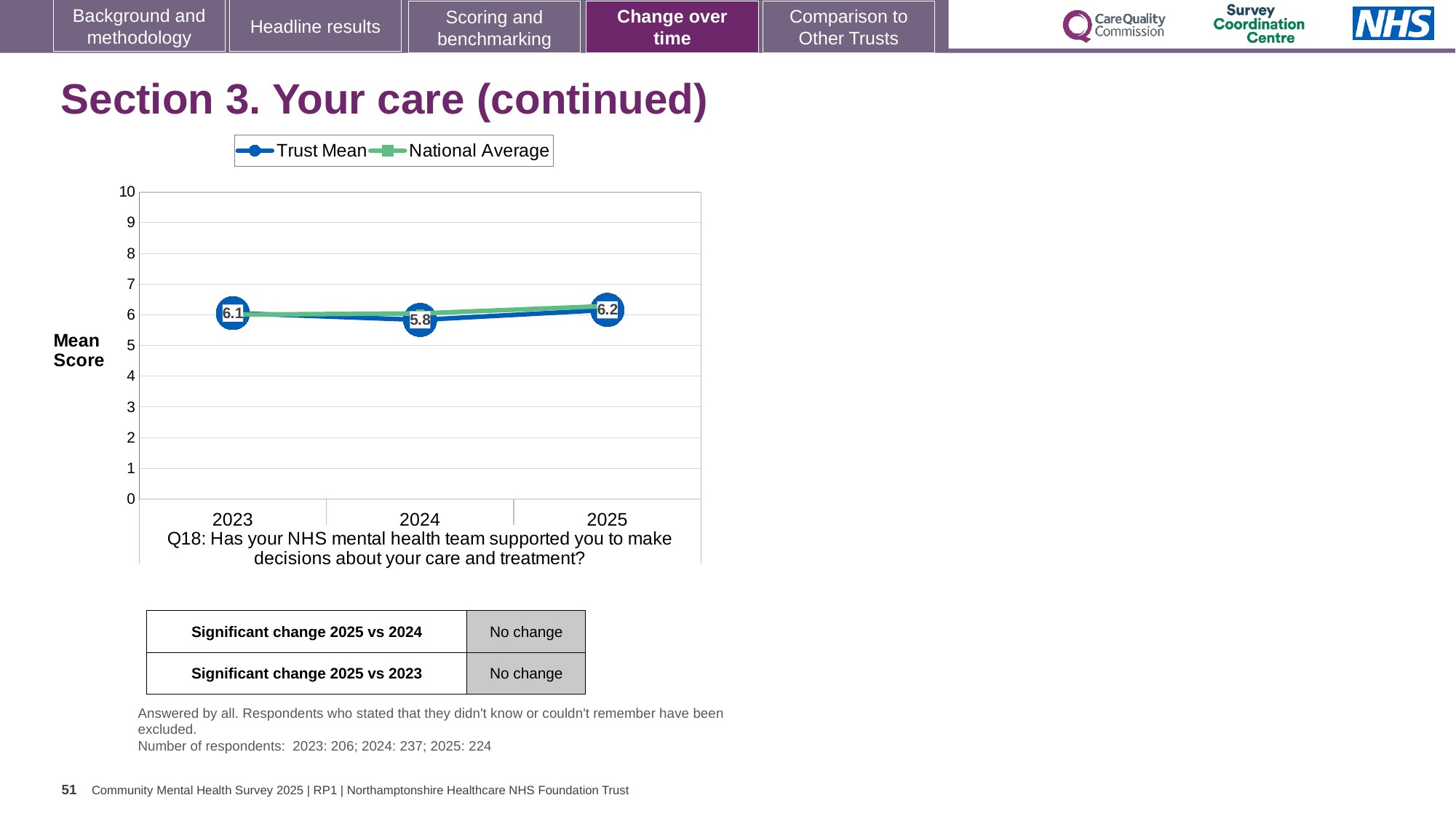
What is the difference between the Trust Mean scores for 2025 and 2024? 0.4 What is the Trust Mean score for 2025? 6.2 What kind of chart is shown on the slide? Line chart How many series does the chart legend list? 2 Which is larger, the Trust Mean score for 2023 or for 2024? 2023 Is the National Average value for 2025 greater or less than 5? greater How many years are shown on the x axis of the chart? 3 Between 2024 and 2025, does the Trust Mean score rise or fall? Rise What is the Trust Mean score for 2024? 5.8 What is the Trust Mean score for 2023? 6.1 In which year is the Trust Mean score lowest? 2024 In which year is the Trust Mean score highest? 2025